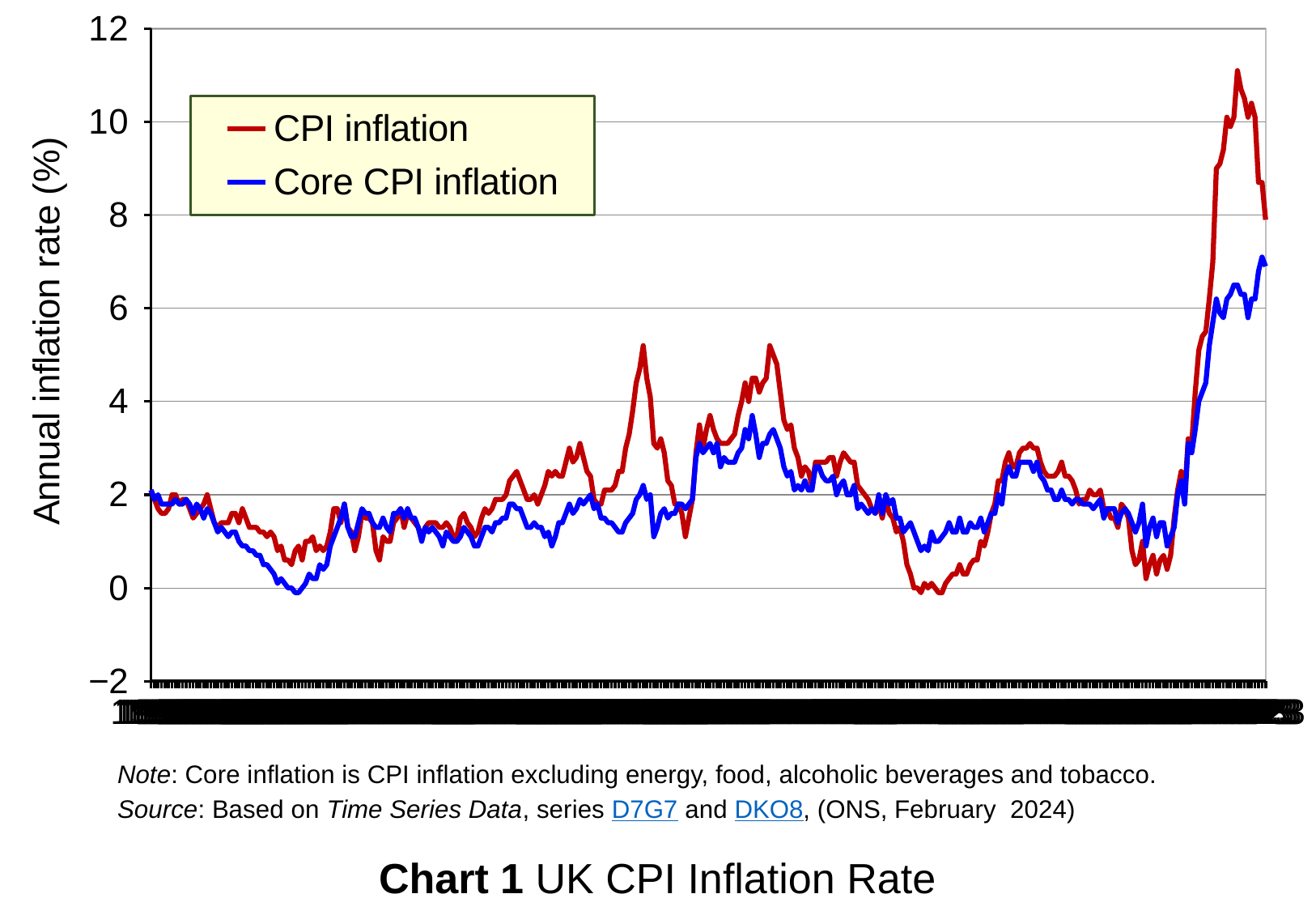
Is the lowest value reached by the CPI inflation line greater or less than 2? less What is the label on the y-axis? Annual inflation rate (%) After reaching its peak near the right of the chart, does the CPI inflation line rise or fall? fall How many series does the legend list? 2 Is the highest value reached by the Core CPI inflation line greater or less than 6? greater Is the highest value reached by the CPI inflation line greater or less than 10? greater What kind of chart is Chart 1 UK CPI Inflation Rate? line chart What is the title of the chart? Chart 1 UK CPI Inflation Rate Which series reaches the higher peak, CPI inflation or Core CPI inflation? CPI inflation At the right-hand end of the chart, which line is higher, CPI inflation or Core CPI inflation? CPI inflation